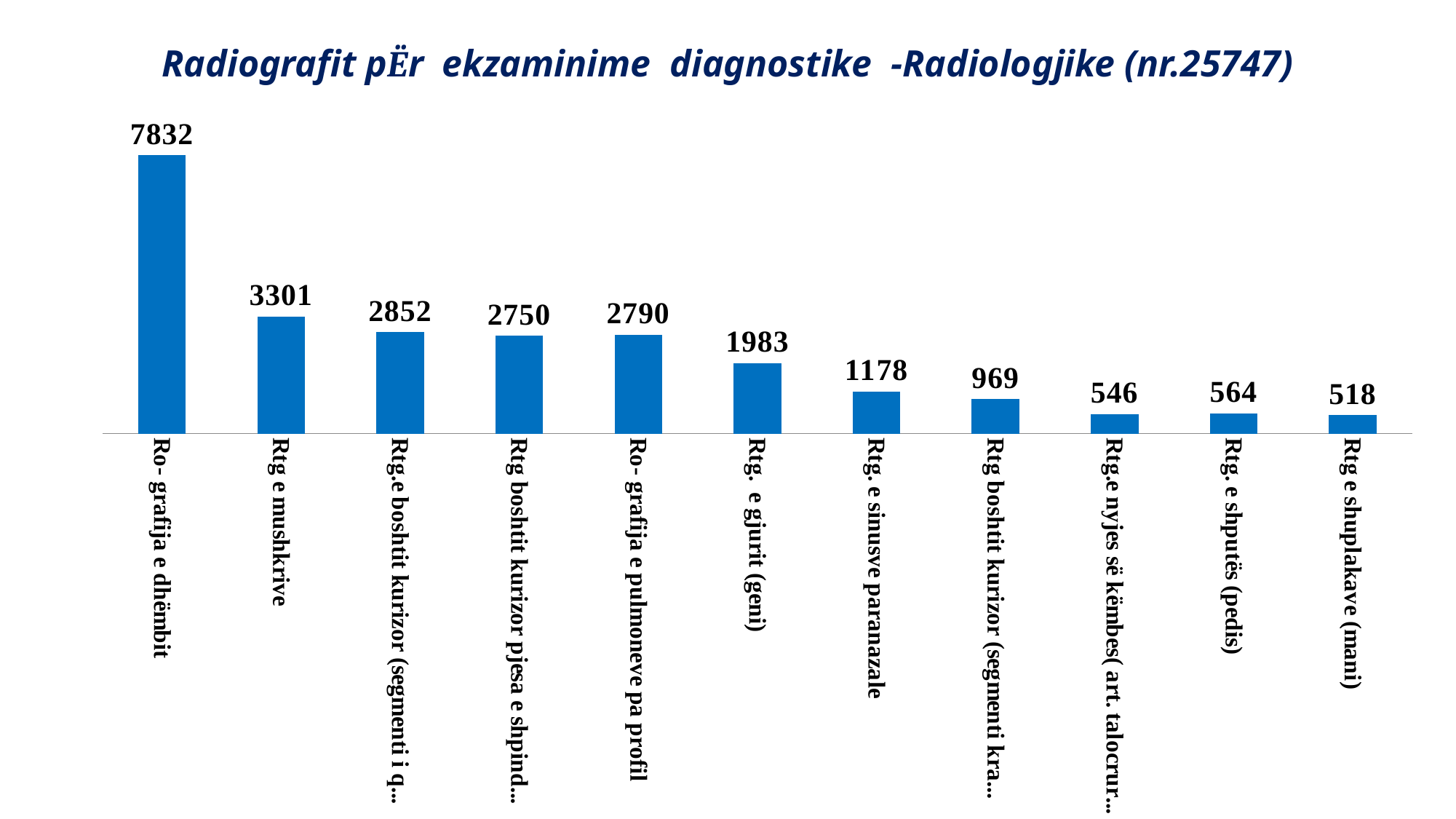
Which category has the highest value? Ro- grafija e dhëmbit What type of chart is shown on the slide? bar chart What is the value for Rtg. e gjurit (geni)? 1983 What is the value for Rtg e mushkrive? 3301 What number is given in parentheses in the chart title? nr.25747 Which is larger, the value for Rtg. e shputës (pedis) or the value for Rtg e shuplakave (mani)? Rtg. e shputës (pedis) What is the value for Rtg e shuplakave (mani)? 518 How many categories are shown in the chart? 11 What is the value for Rtg. e sinusve paranazale? 1178 What is the value for Ro- grafija e dhëmbit? 7832 Which category has the lowest value? Rtg e shuplakave (mani) What is the difference between the values for Ro- grafija e dhëmbit and Rtg e mushkrive? 4531